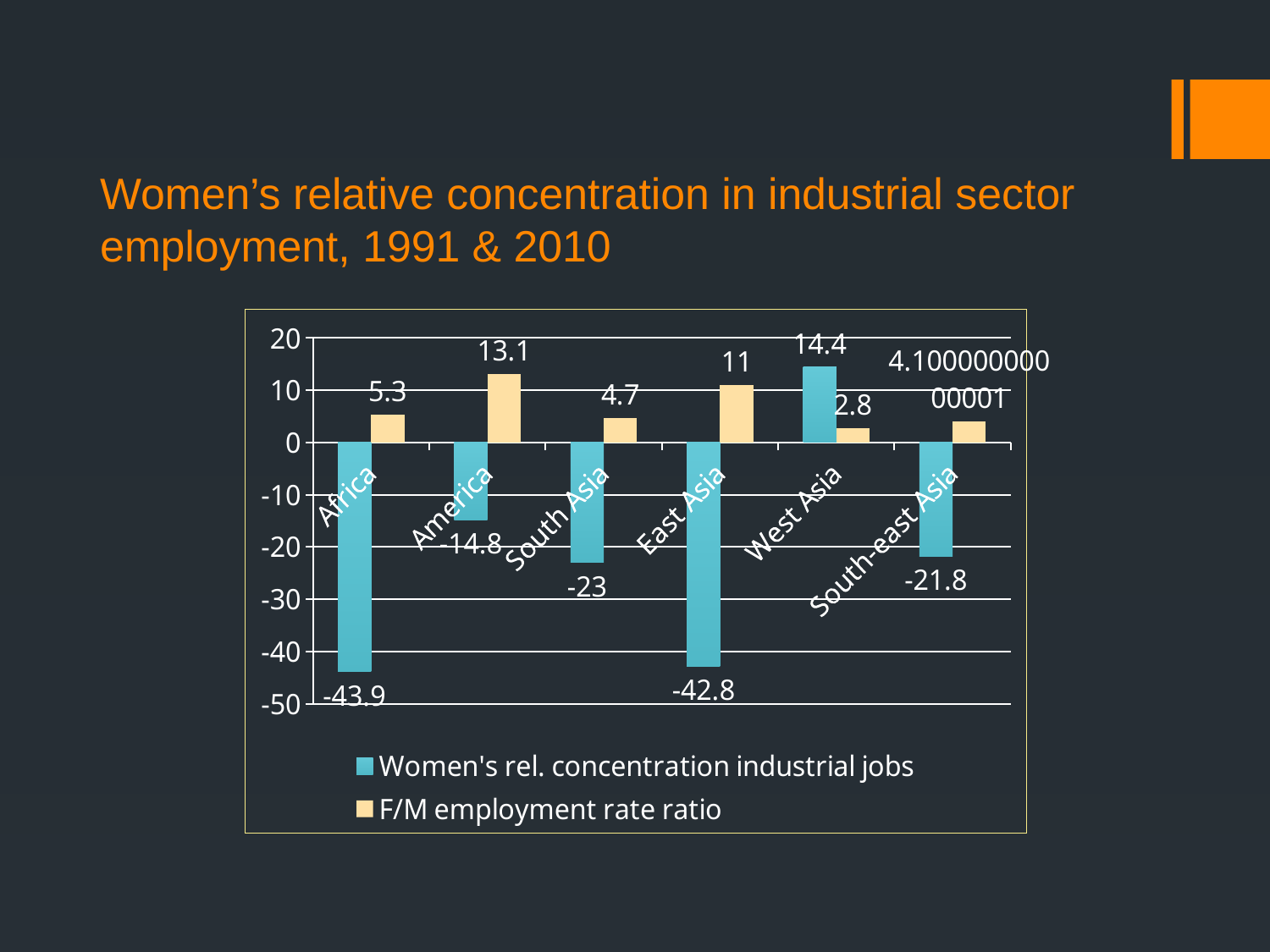
Which is larger in Women's rel. concentration industrial jobs: South Asia or South-east Asia? South-east Asia What is the F/M employment rate ratio for East Asia? 11 Which region is the only one with a positive value for Women's rel. concentration industrial jobs? West Asia What is the difference between the F/M employment rate ratio for America and for West Asia? 10.3 Which region has the lowest value for Women's rel. concentration industrial jobs? Africa What is the value of Women's rel. concentration industrial jobs for Africa? -43.9 How many regions are shown on the x axis? 6 What is the F/M employment rate ratio for America? 13.1 How many series does the legend list? 2 Which region has the highest F/M employment rate ratio? America What type of chart is shown on the slide? Bar chart What is the value of Women's rel. concentration industrial jobs for West Asia? 14.4